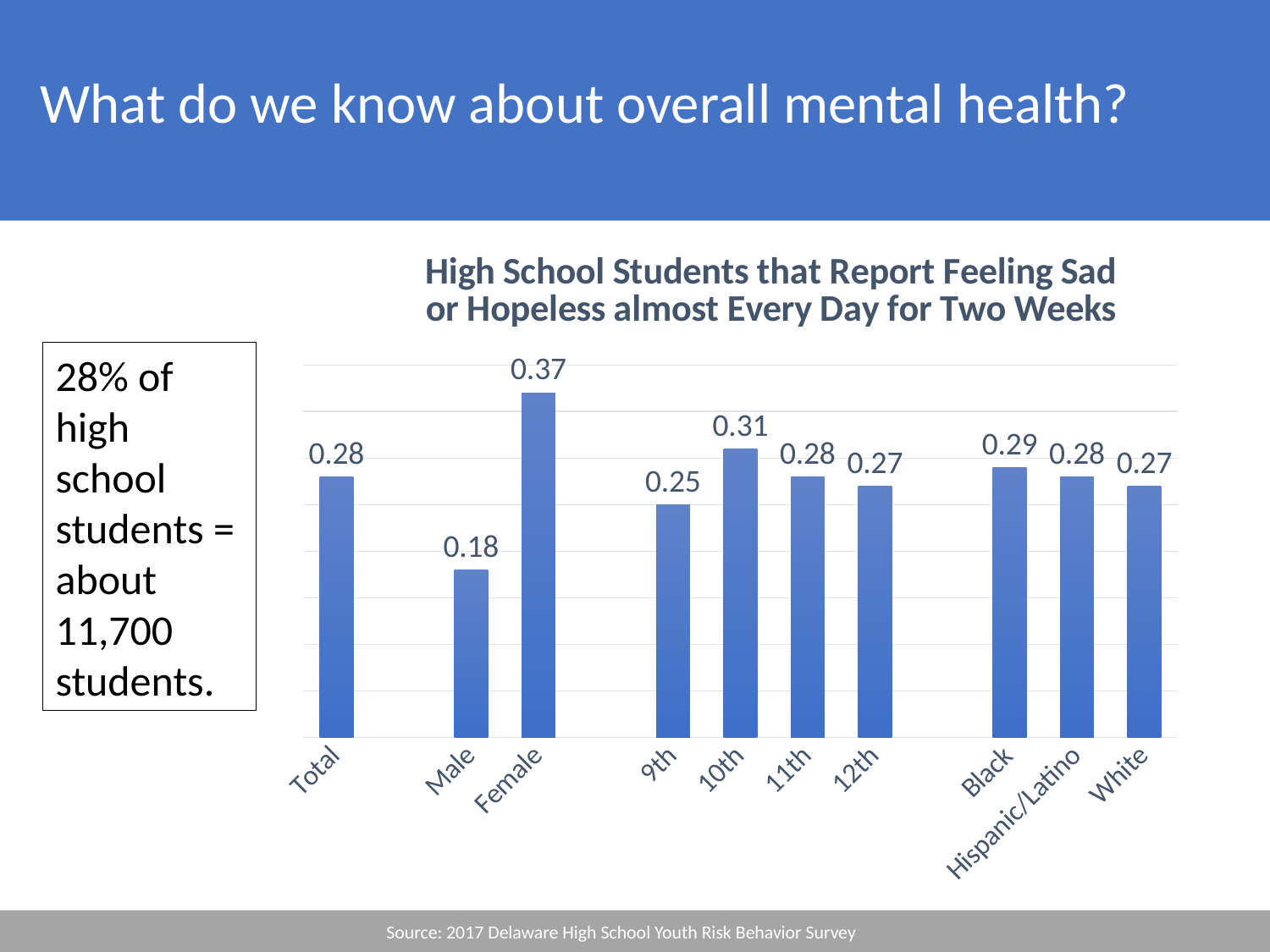
What is the difference between the values for Female and Male? 0.19 What is the difference between the values for 10th and 9th? 0.06 Which category has the lowest value? Male What is the title of the chart? High School Students that Report Feeling Sad or Hopeless almost Every Day for Two Weeks What kind of chart is this? Bar chart What is the value for 10th? 0.31 What is the value for Hispanic/Latino? 0.28 What is the value for Male? 0.18 Which category has the highest value? Female How many categories are shown on the x axis? 10 Which is larger, the value for 9th or the value for 10th? 10th What is the value for Female? 0.37